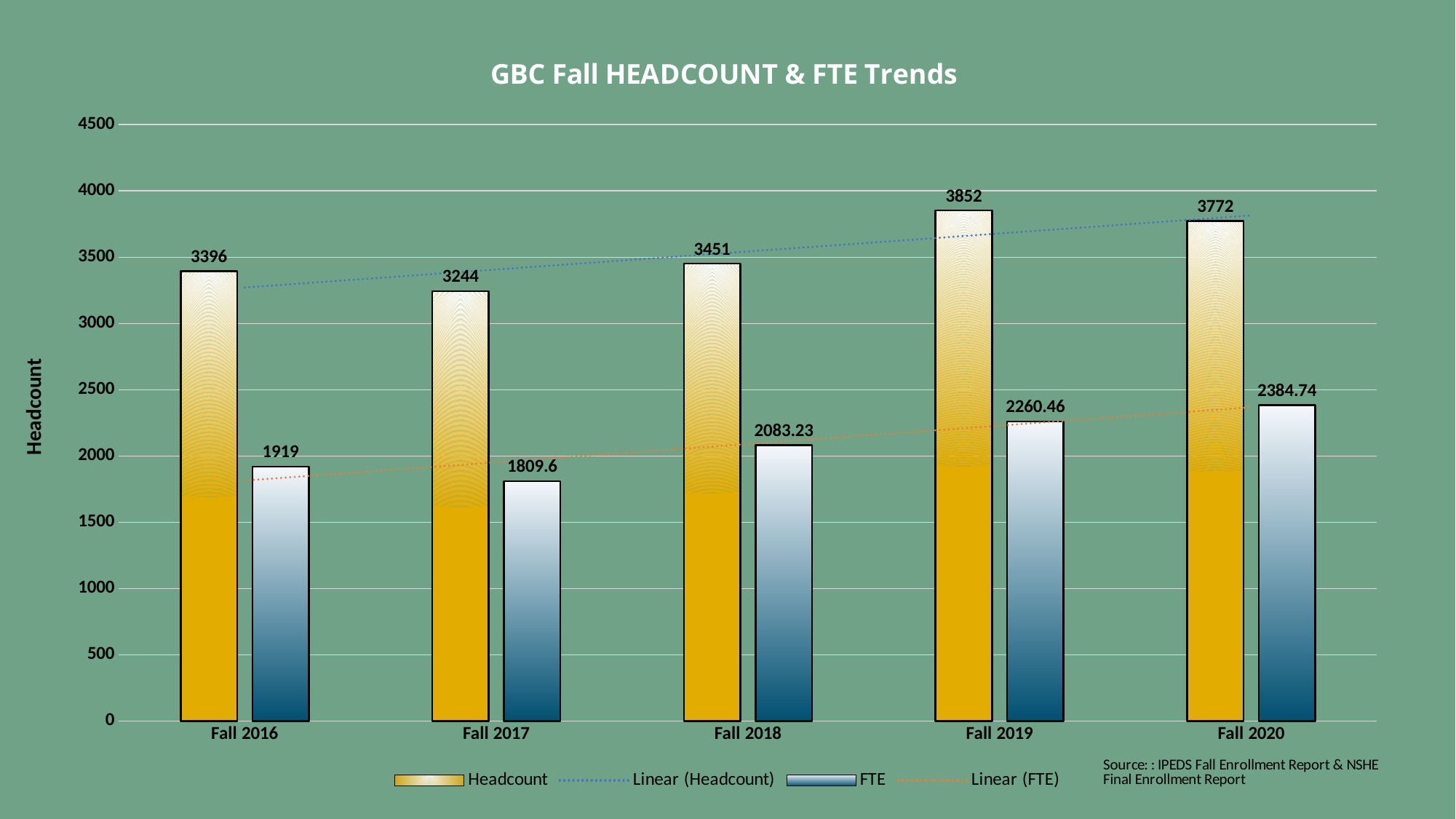
Which is larger, the Headcount for Fall 2016 or the Headcount for Fall 2017? Fall 2016 What kind of chart is this? Bar chart Is the FTE value for Fall 2019 greater or less than 2000? greater How many fall terms are shown on the x axis? 5 What is the FTE value for Fall 2017? 1809.6 How many entries does the legend list? 4 What is the Headcount value for Fall 2018? 3451 Which fall term has the lowest FTE? Fall 2017 Which fall term has the highest Headcount? Fall 2019 What is the difference between the Headcount for Fall 2019 and Fall 2020? 80 What is the FTE value for Fall 2020? 2384.74 What is the title of the chart? GBC Fall HEADCOUNT & FTE Trends